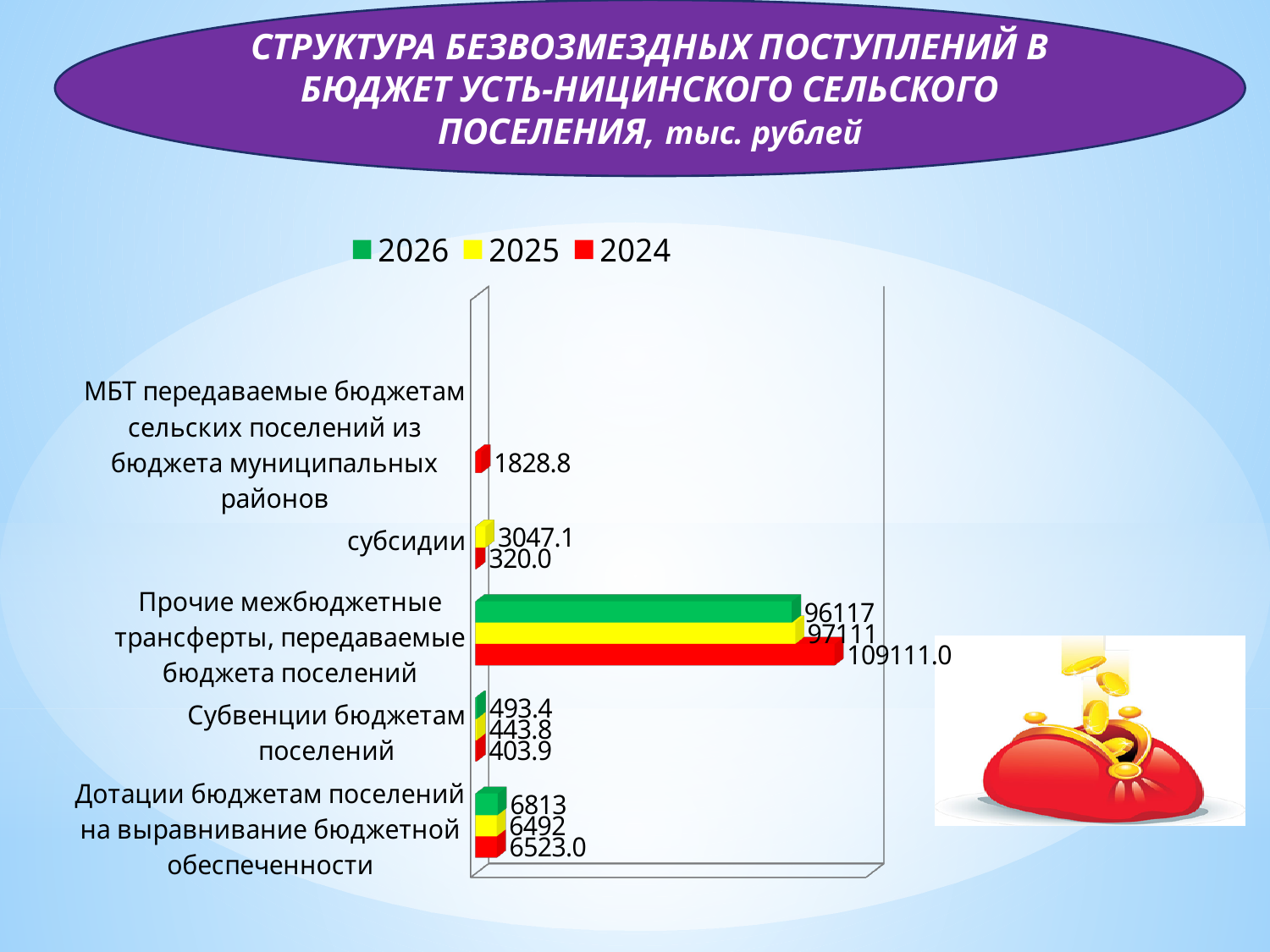
How many categories are shown on the chart? 5 How many series does the legend list? 3 What is the 2026 value for Дотации бюджетам поселений на выравнивание бюджетной обеспеченности? 6813 What is the 2024 value for МБТ передаваемые бюджетам сельских поселений из бюджета муниципальных районов? 1828.8 Which category has the highest 2024 value? Прочие межбюджетные трансферты, передаваемые бюджета поселений For Субвенции бюджетам поселений, which year has the larger value, 2026 or 2024? 2026 Which category has the lowest 2024 value? субсидии What is the 2025 value for субсидии? 3047.1 What kind of chart is shown on the slide? Bar chart What is the difference between the 2025 and 2026 values for Прочие межбюджетные трансферты, передаваемые бюджета поселений? 994 What is the 2024 value for Прочие межбюджетные трансферты, передаваемые бюджета поселений? 109111.0 What is the 2025 value for Субвенции бюджетам поселений? 443.8